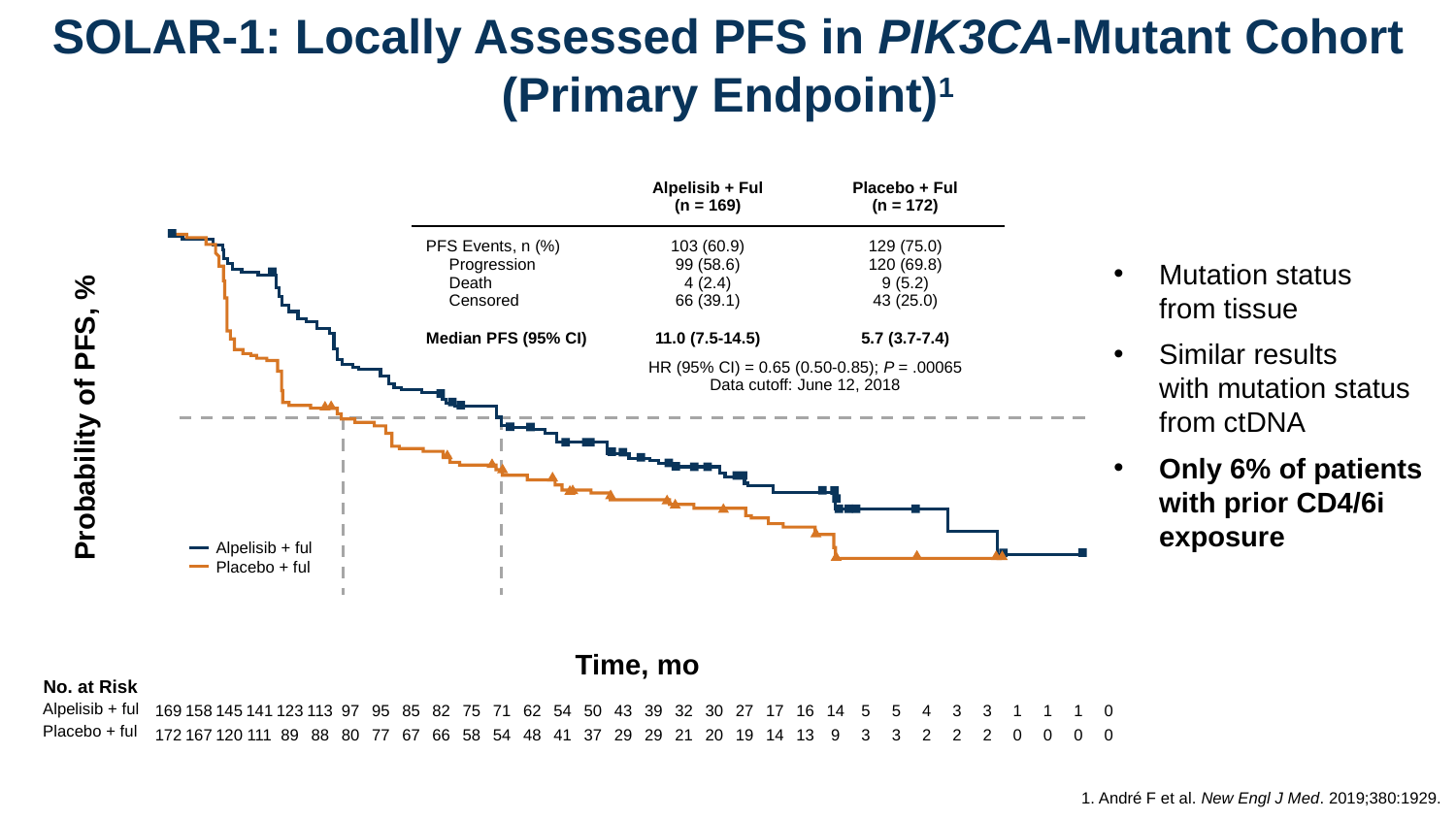
What is the hazard ratio (95% CI) shown on the chart? 0.65 (0.50-0.85) What is the median PFS (95% CI) for the Alpelisib + Ful arm? 11.0 (7.5-14.5) In the No. at Risk table, how many patients were at risk in the Placebo + ful arm at the first time point? 172 What is the label of the y axis? Probability of PFS, % What are the two series named in the legend? Alpelisib + ful and Placebo + ful Do the probability of PFS curves rise or fall as time increases along the x axis? Fall What is the difference in median PFS (months) between the Alpelisib + Ful and Placebo + Ful arms? 5.3 What is the median PFS (95% CI) for the Placebo + Ful arm? 5.7 (3.7-7.4) How many PFS events, n (%), were reported in the Placebo + Ful arm? 129 (75.0) How many series does the legend list? 2 Which arm has the higher median PFS, Alpelisib + Ful or Placebo + Ful? Alpelisib + Ful What kind of chart is shown on the slide? Line chart (Kaplan-Meier survival curve)